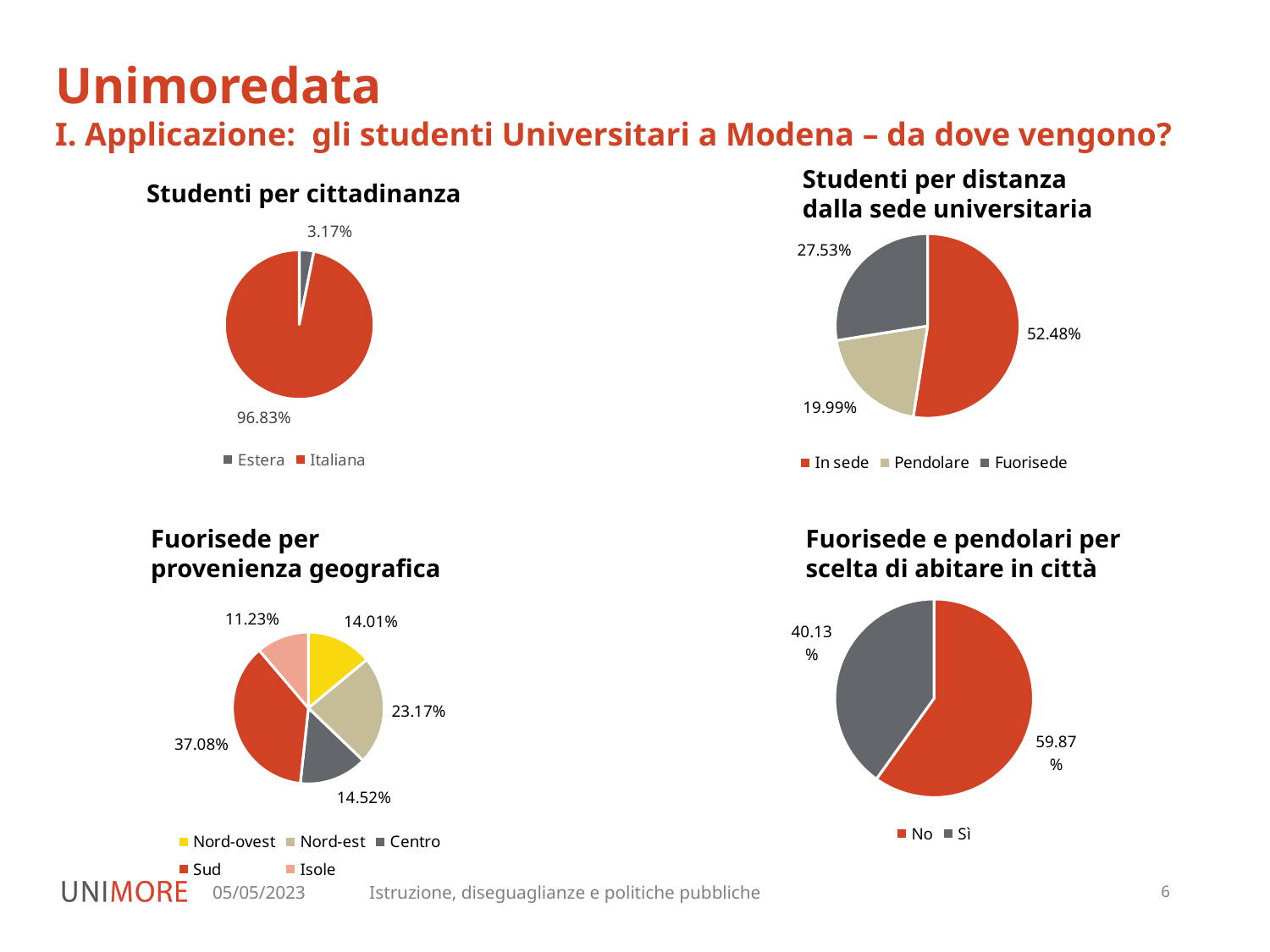
In the 'Fuorisede e pendolari per scelta di abitare in città' chart, what is the value for Sì? 40.13% In the 'Studenti per distanza dalla sede universitaria' chart, which category has the largest share? In sede In the 'Studenti per distanza dalla sede universitaria' chart, what is the value for Pendolare? 19.99% How many entries does the legend of the 'Studenti per distanza dalla sede universitaria' chart list? 3 In the 'Fuorisede per provenienza geografica' chart, which is larger, Nord-est or Centro? Nord-est In the 'Studenti per cittadinanza' chart, what share of students is Estera? 3.17% What type of chart is 'Fuorisede e pendolari per scelta di abitare in città'? Pie chart In the 'Studenti per cittadinanza' chart, what share of students is Italiana? 96.83% In the 'Studenti per distanza dalla sede universitaria' chart, what is the difference between the In sede and Fuorisede shares? 24.95% How many categories does the 'Fuorisede per provenienza geografica' chart show? 5 In the 'Fuorisede per provenienza geografica' chart, what is the value for Sud? 37.08% In the 'Fuorisede per provenienza geografica' chart, which category has the smallest share? Isole